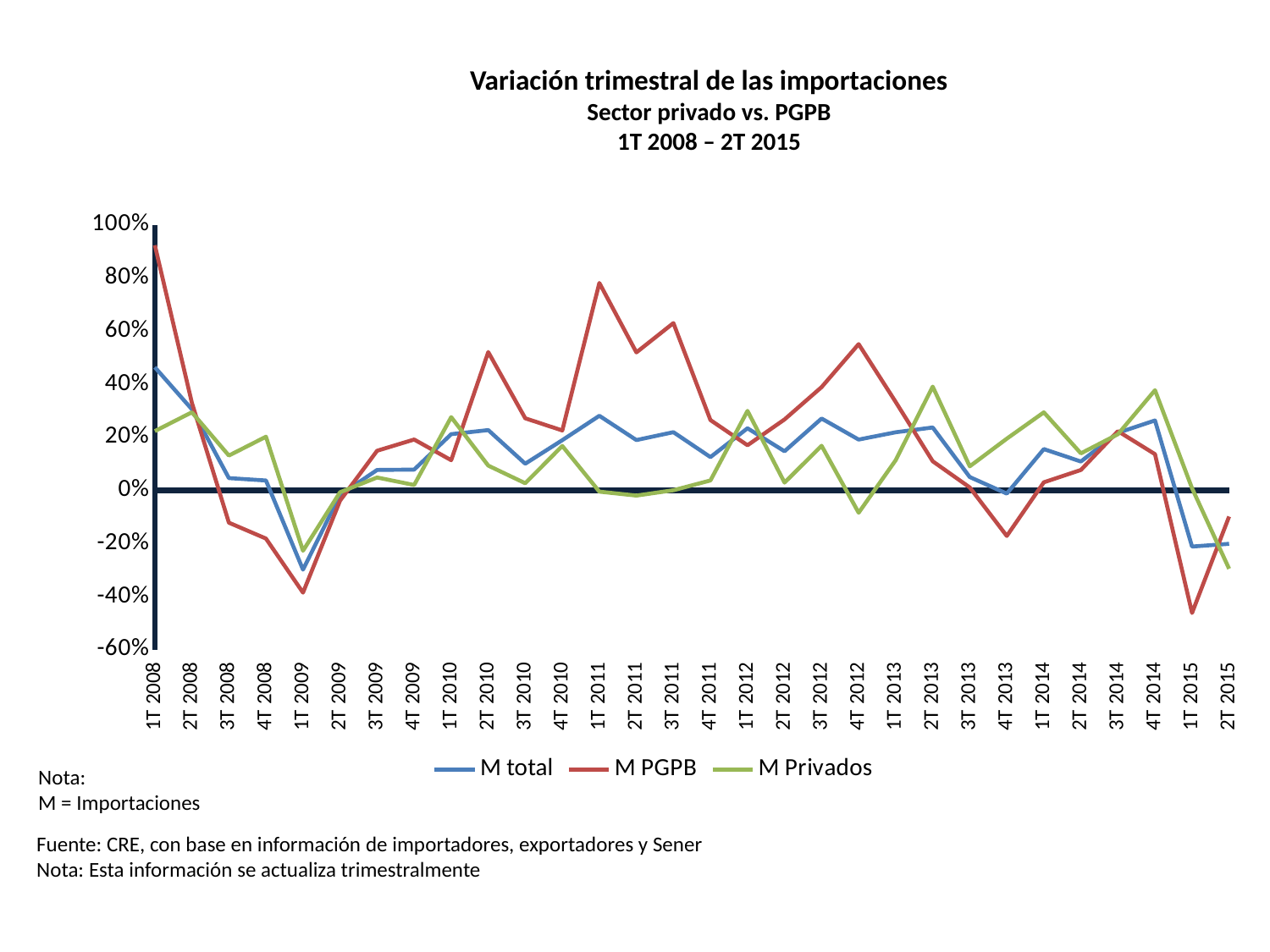
Does the M PGPB series rise or fall from 1T 2008 to 1T 2009? fall In which quarter does the M total series reach its highest value? 1T 2008 How many series does the legend list? 3 How many quarters are plotted along the x axis? 30 In 4T 2012, which series has the larger value, M PGPB or M total? M PGPB In which quarter does the M PGPB series reach its lowest value? 1T 2015 What kind of chart is shown on the slide? line chart In which quarter does the M PGPB series reach its highest value? 1T 2008 In 1T 2011, which series has the larger value, M PGPB or M Privados? M PGPB Is the value for M PGPB in 1T 2011 greater or less than 60%? greater Is the value for M Privados in 4T 2012 greater or less than 0%? less Is the value for M total in 1T 2009 greater or less than -20%? less